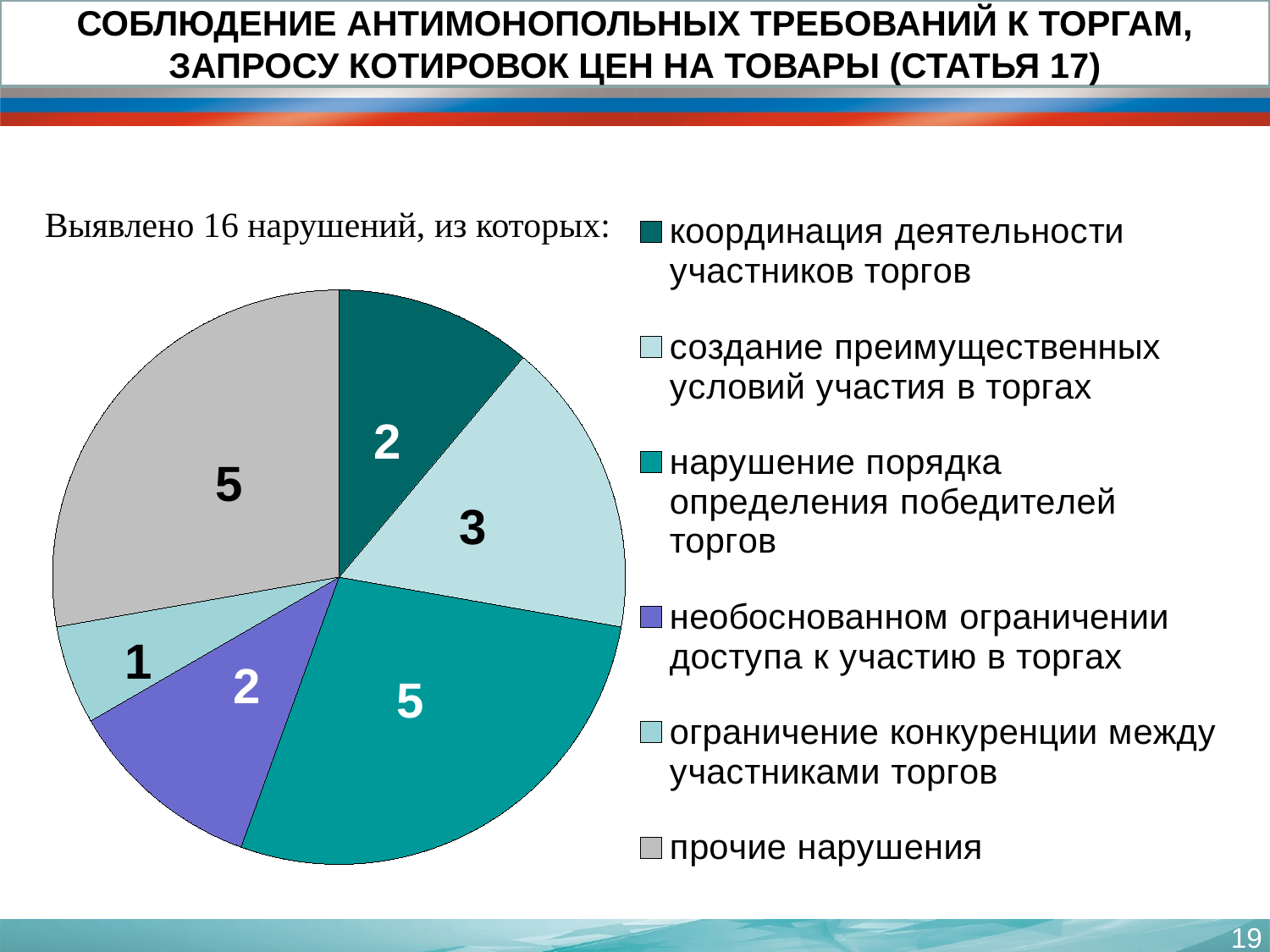
What is the value for "ограничение конкуренции между участниками торгов"? 1 What kind of chart is shown on the slide? pie chart What is the value for "нарушение порядка определения победителей торгов"? 5 What is the value for "координация деятельности участников торгов"? 2 What is the value for "создание преимущественных условий участия в торгах"? 3 How many slices does the pie chart have? 6 What share of the total does the "прочие нарушения" slice represent? 31.25% How many entries does the legend list? 6 What colour is the slice for "необоснованном ограничении доступа к участию в торгах"? purple Which is larger: the value for "необоснованном ограничении доступа к участию в торгах" or the value for "создание преимущественных условий участия в торгах"? создание преимущественных условий участия в торгах Which category has the smallest slice in the pie chart? ограничение конкуренции между участниками торгов What is the difference between the values for "прочие нарушения" and "создание преимущественных условий участия в торгах"? 2